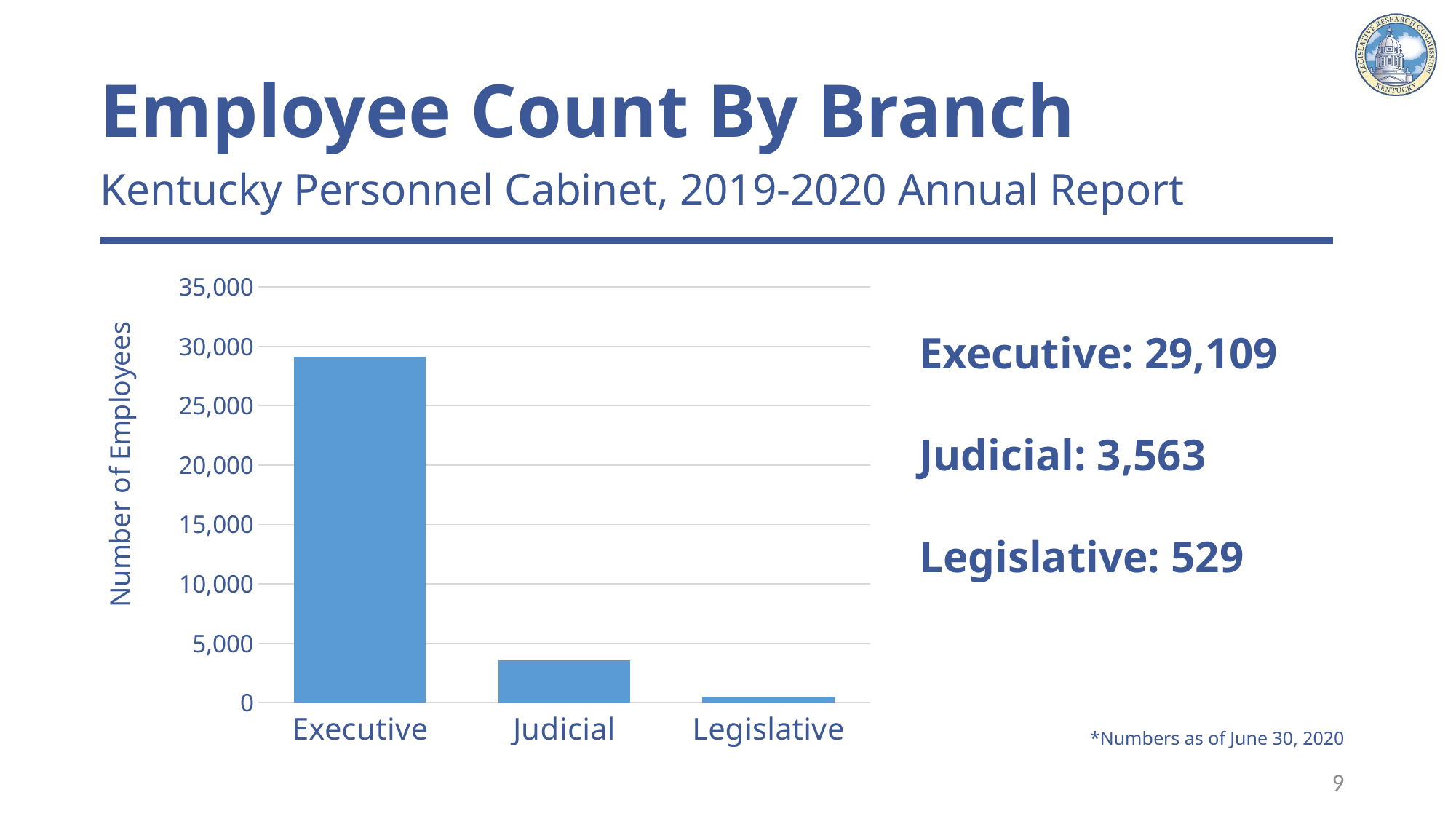
Is the value for Executive greater or less than 25,000? greater What is the number of employees in the Executive branch? 29,109 Is the value for Judicial greater or less than 5,000? less How many more employees does the Executive branch have than the Judicial branch? 25,546 Which has more employees, the Judicial branch or the Legislative branch? Judicial What is the difference in employee count between the Judicial and Legislative branches? 3,034 What is the number of employees in the Judicial branch? 3,563 What type of chart is shown on the slide? Bar chart Which branch has the highest employee count? Executive Which branch has the lowest employee count? Legislative What is the number of employees in the Legislative branch? 529 How many branches are shown on the chart? 3